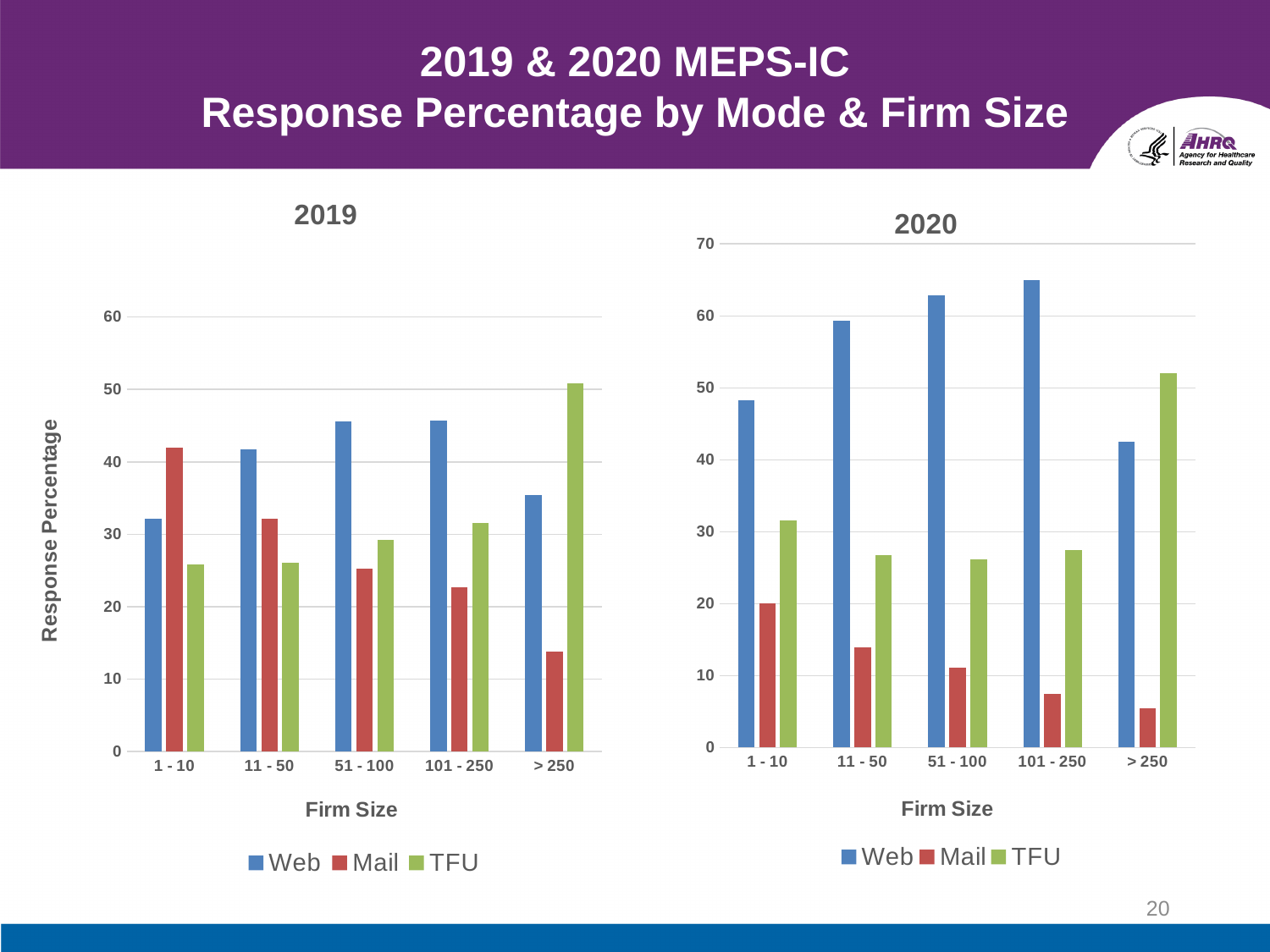
How many series does the legend of the 2020 chart list? 3 What kind of chart is the 2019 chart on the left? bar chart How many firm size categories are shown on the x axis of the 2019 chart? 5 In the 2020 chart, does the Mail response percentage rise or fall as firm size increases from 1 - 10 to > 250? fall In the 2019 chart, for firm size 1 - 10, which is larger: Web or Mail? Mail In the 2020 chart, which firm size has the lowest Mail response percentage? > 250 What is the title of the vertical axis on the 2019 chart? Response Percentage In the 2019 chart, is the Mail value for firm size 1 - 10 greater or less than 40? greater In the 2020 chart, is the Web value for firm size 51 - 100 greater or less than 60? greater In the 2020 chart, for firm size > 250, which is larger: Web or TFU? TFU In the 2019 chart, which firm size has the highest TFU response percentage? > 250 In the 2020 chart, is the Mail value for firm size 101 - 250 greater or less than 10? less